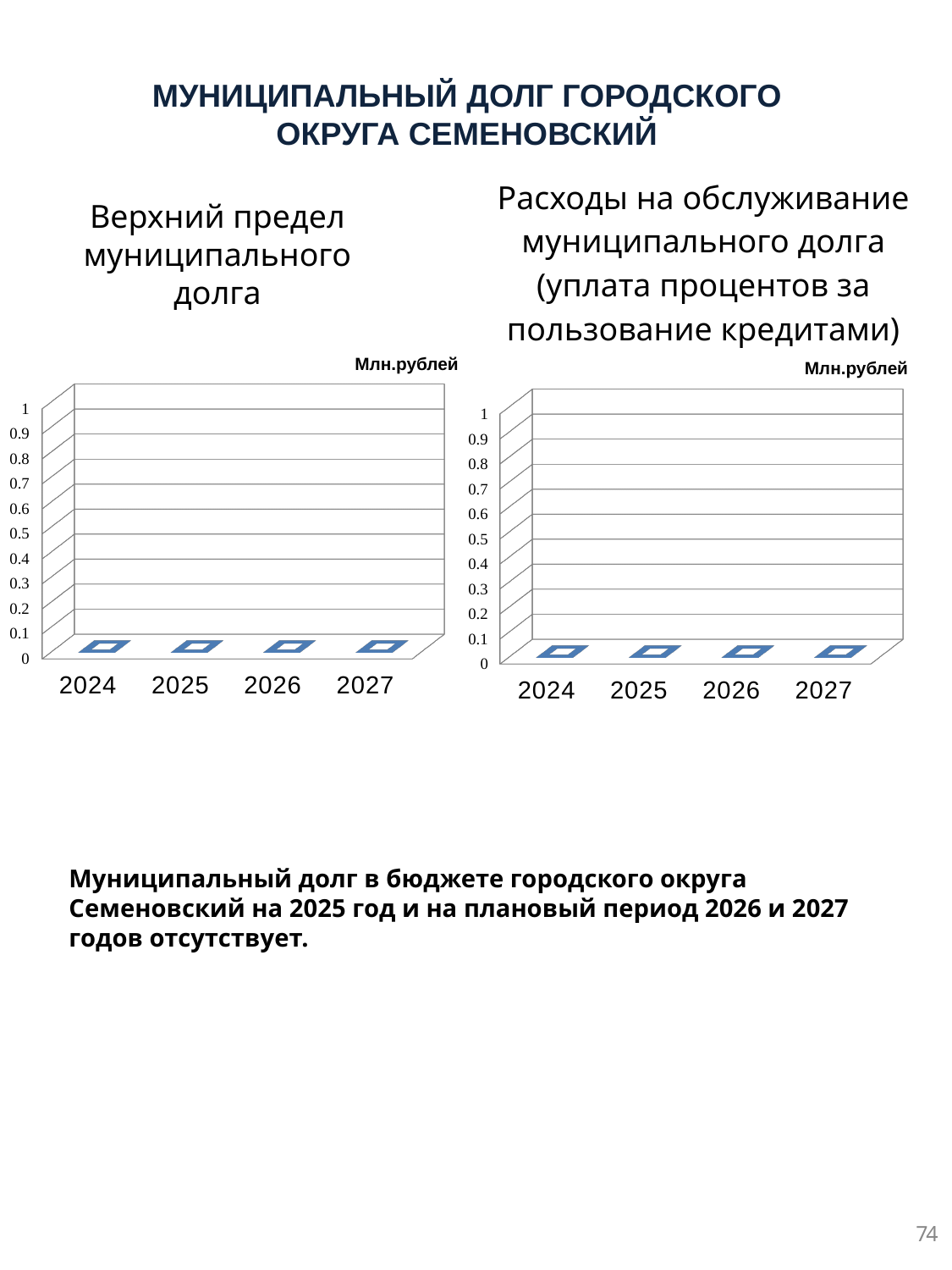
How many categories are shown on the x axis of the right chart, "Расходы на обслуживание муниципального долга"? 4 Do the values in the left chart, "Верхний предел муниципального долга", rise, fall or stay flat from 2024 to 2027? stay flat In the right chart, "Расходы на обслуживание муниципального долга", is the value for 2027 greater or less than 0.1? less What kind of chart is the right chart, "Расходы на обслуживание муниципального долга"? bar chart In the left chart, "Верхний предел муниципального долга", is the value for 2025 greater or less than 0.5? less What is the highest tick shown on the vertical axis of the left chart, "Верхний предел муниципального долга"? 1 In the left chart, "Верхний предел муниципального долга", what value does the bar for 2024 land on? 0 What kind of chart is the left chart, "Верхний предел муниципального долга"? bar chart How many years are shown on the x axis of the left chart, "Верхний предел муниципального долга"? 4 What is the first year shown on the x axis of the right chart, "Расходы на обслуживание муниципального долга"? 2024 What unit is indicated above the right chart, "Расходы на обслуживание муниципального долга"? Млн.рублей In the right chart, "Расходы на обслуживание муниципального долга", what value does the bar for 2026 land on? 0